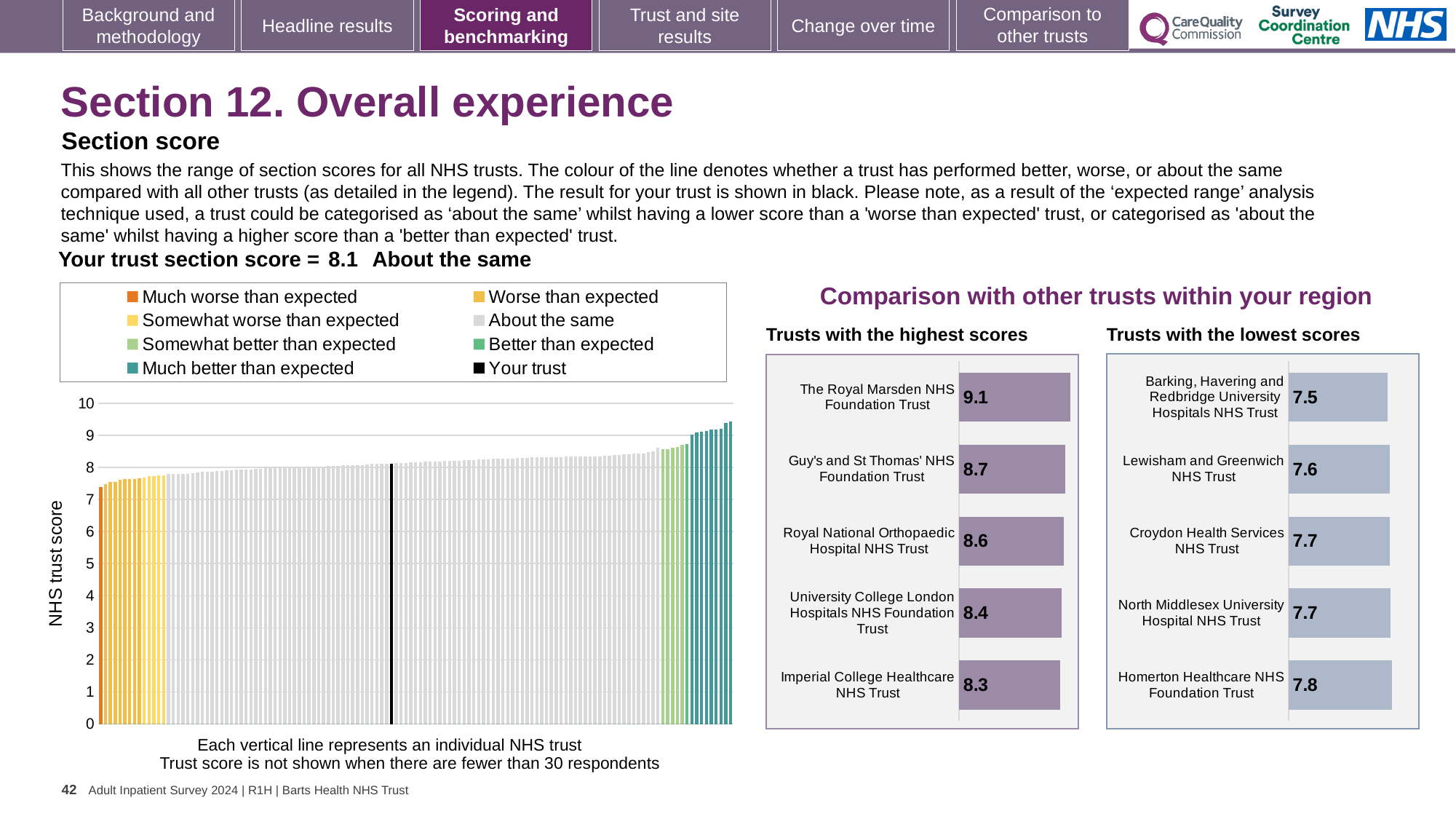
In the NHS trust score chart on the left, what is the section score for your trust? 8.1 In the 'Trusts with the lowest scores' chart, which has the larger score: Lewisham and Greenwich NHS Trust or Homerton Healthcare NHS Foundation Trust? Homerton Healthcare NHS Foundation Trust In the 'Trusts with the highest scores' chart, what is the difference between the scores of The Royal Marsden NHS Foundation Trust and Guy's and St Thomas' NHS Foundation Trust? 0.4 In the 'Trusts with the lowest scores' chart, which trust has the highest score? Homerton Healthcare NHS Foundation Trust What kind of chart is the NHS trust score chart on the left of the slide? Bar chart How many trusts are shown in the 'Trusts with the lowest scores' chart? 5 In the 'Trusts with the highest scores' chart, which trust has the lowest score? Imperial College Healthcare NHS Trust How many entries does the legend of the NHS trust score chart on the left list? 8 In the NHS trust score chart on the left, is the value of the tallest bar greater or less than 9? greater In the 'Trusts with the lowest scores' chart, what is the score for Barking, Havering and Redbridge University Hospitals NHS Trust? 7.5 In the 'Trusts with the highest scores' chart, what is the score for Imperial College Healthcare NHS Trust? 8.3 In the 'Trusts with the highest scores' chart, what is the score for The Royal Marsden NHS Foundation Trust? 9.1